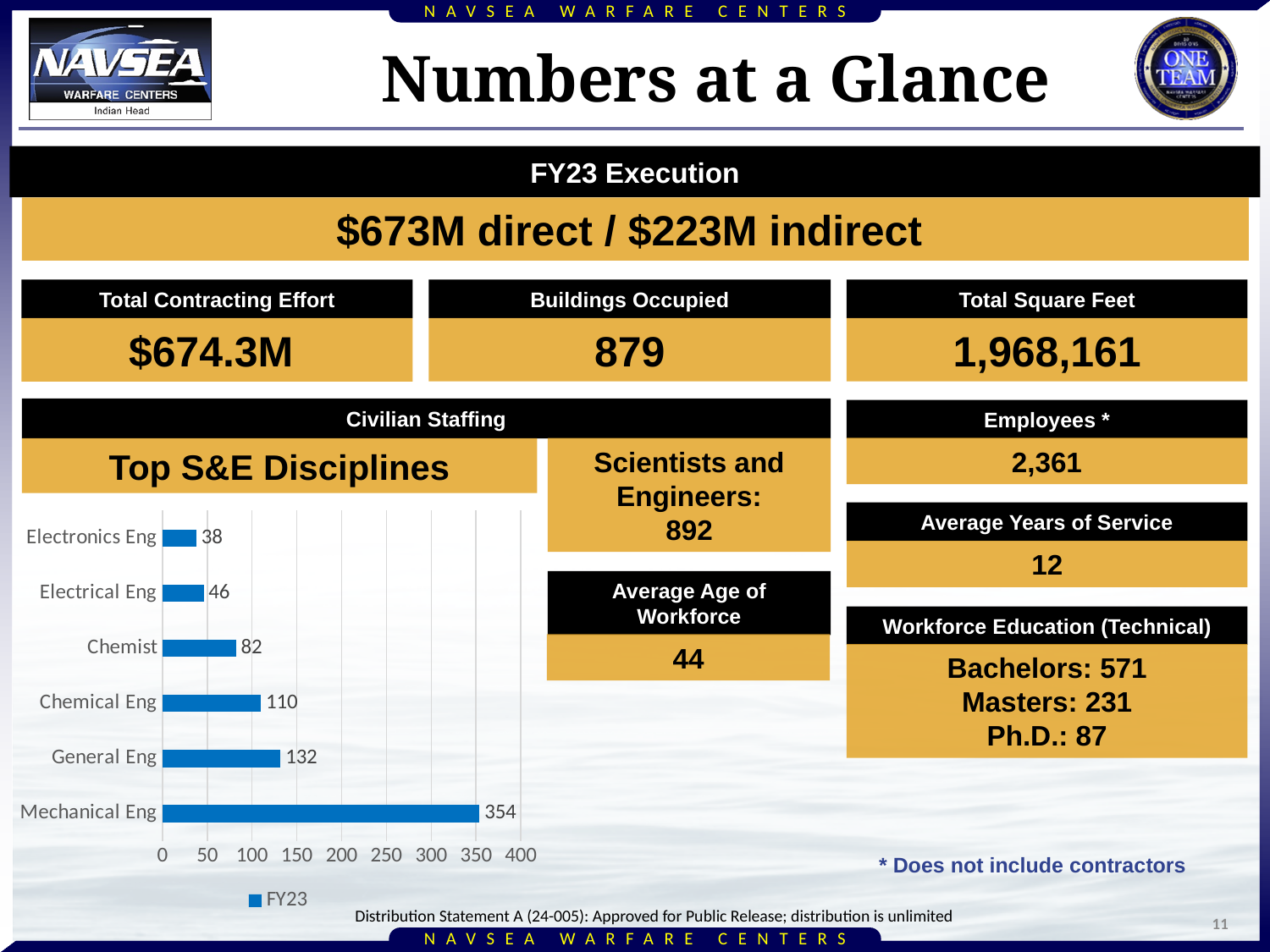
What is the value for Mechanical Eng in the Top S&E Disciplines chart? 354 What is the difference between the values for General Eng and Chemical Eng in the Top S&E Disciplines chart? 22 Is the value for Mechanical Eng in the Top S&E Disciplines chart greater or less than 300? greater Which discipline has the highest value in the Top S&E Disciplines chart? Mechanical Eng How many series does the legend of the Top S&E Disciplines chart list? 1 What kind of chart is the Top S&E Disciplines chart? Bar chart Which is larger in the Top S&E Disciplines chart, Chemist or Chemical Eng? Chemical Eng What is the value for Chemist in the Top S&E Disciplines chart? 82 Which discipline has the lowest value in the Top S&E Disciplines chart? Electronics Eng What is the value for Electrical Eng in the Top S&E Disciplines chart? 46 How many disciplines are shown in the Top S&E Disciplines chart? 6 What series name is shown in the legend of the Top S&E Disciplines chart? FY23